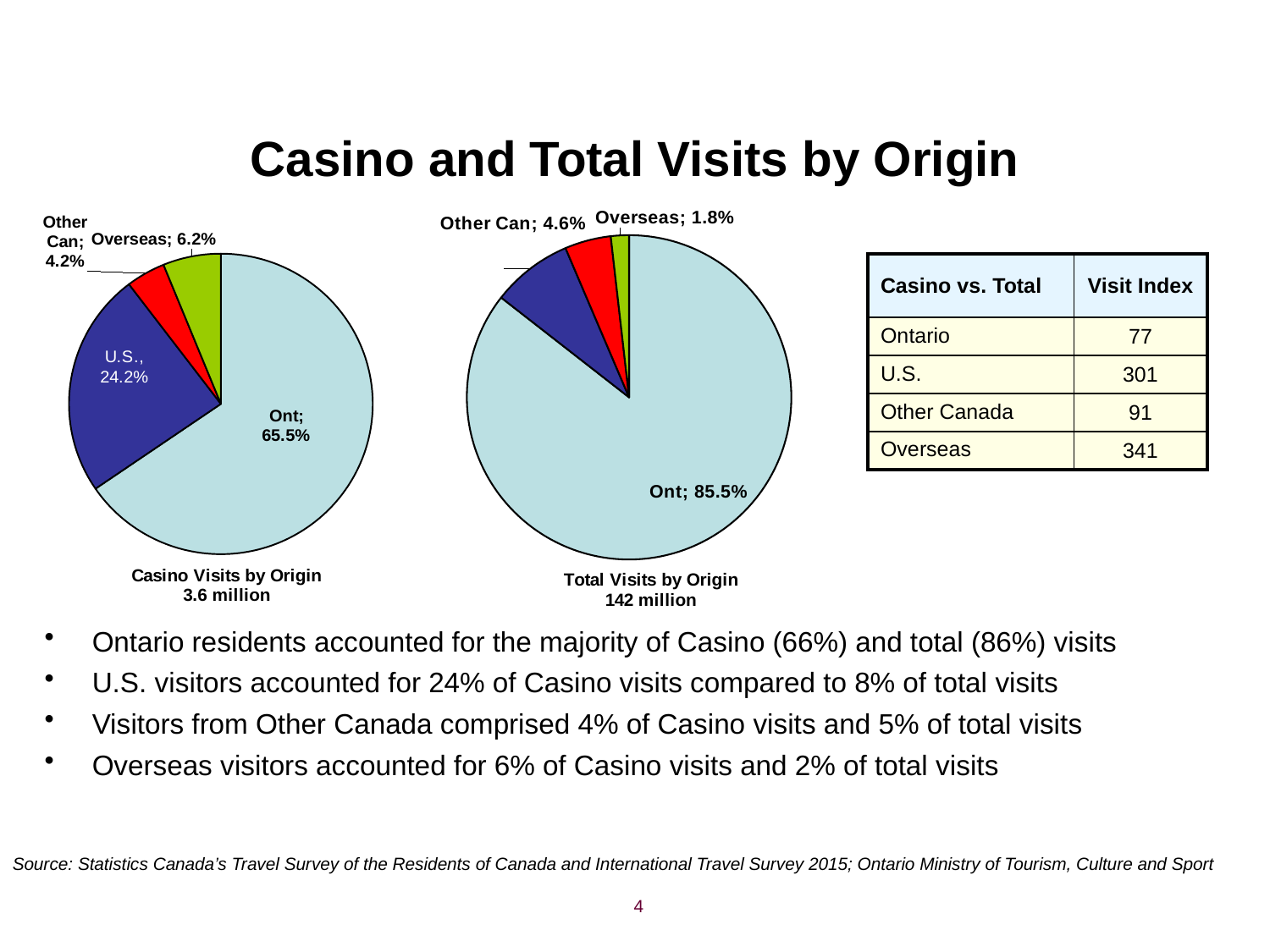
In the Casino Visits by Origin pie chart, what share of visits is from Ontario? 65.5% What is the difference between Ontario's share in the Total Visits by Origin chart and its share in the Casino Visits by Origin chart? 20 percentage points In the Total Visits by Origin pie chart, what share of visits is from Overseas? 1.8% In the Total Visits by Origin pie chart, what share of visits is from Other Can? 4.6% What type of chart is used for Casino Visits by Origin? Pie chart In the Casino Visits by Origin pie chart, which origin has the smallest slice? Other Can In the Total Visits by Origin pie chart, which origin has the largest slice? Ont In the Casino Visits by Origin pie chart, which slice is larger: Overseas or Other Can? Overseas